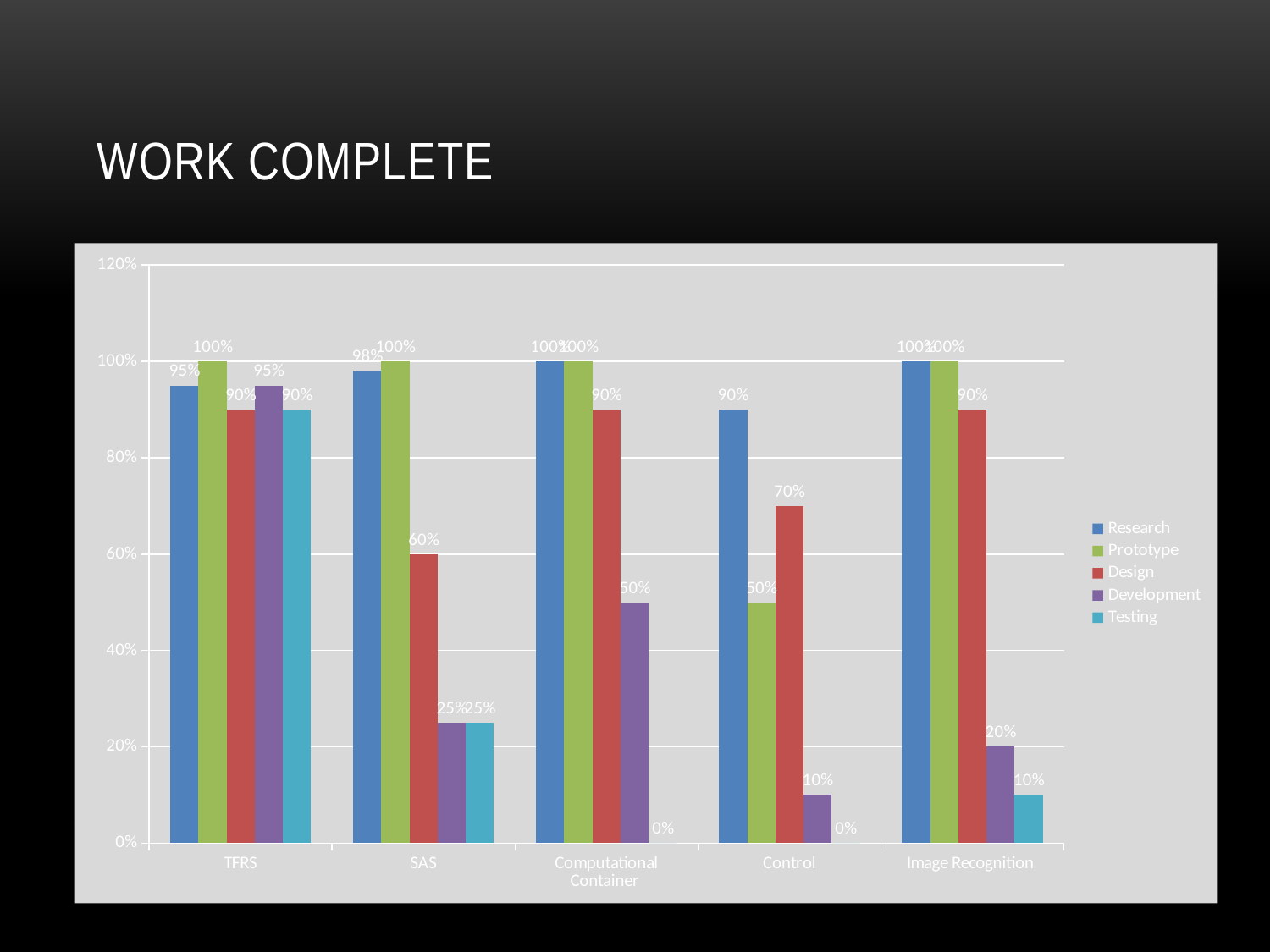
Which is larger for Control: the Research value or the Design value? Research How many categories are shown on the x axis? 5 What type of chart is shown on the slide? bar chart How many series does the legend list? 5 What is the Testing value for Image Recognition? 10% What is the Research value for SAS? 98% What is the difference between the Design and Prototype values for Control? 20% Which category has the highest Development value? TFRS What is the title of the slide? WORK COMPLETE What is the Design value for SAS? 60% What is the Development value for Computational Container? 50% Which category has the lowest Design value? SAS